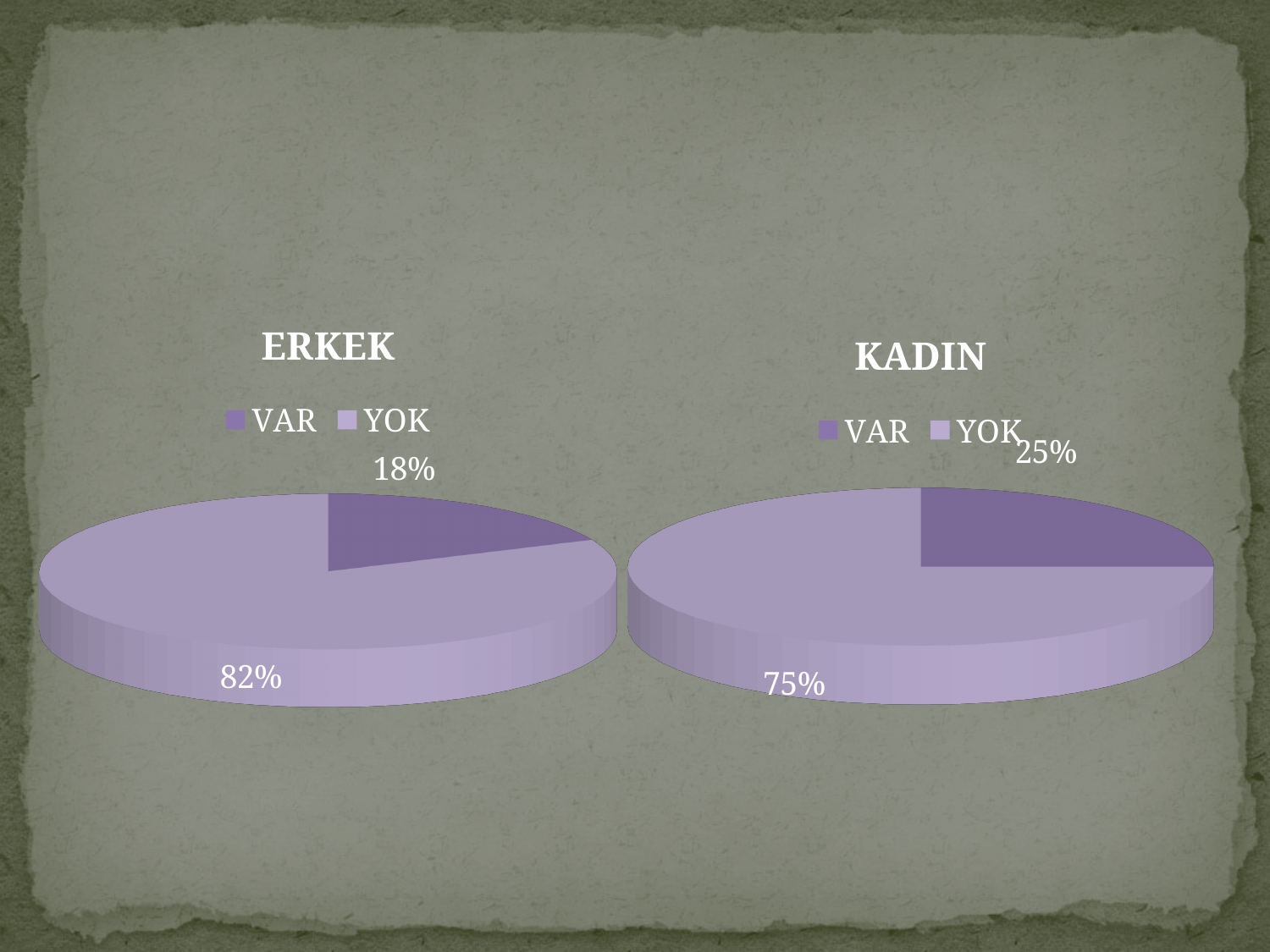
In the KADIN chart, what share does YOK have? 75% In the KADIN chart, what is the difference between the YOK and VAR shares? 50% Which chart has the larger VAR share, ERKEK or KADIN? KADIN In the ERKEK chart, which slice is the largest? YOK In the KADIN chart, what share does VAR have? 25% What kind of chart is the ERKEK chart? Pie chart What are the legend entries of the ERKEK chart? VAR, YOK In the KADIN chart, which slice is the smallest? VAR In the ERKEK chart, what share does VAR have? 18% How many slices does the KADIN chart have? 2 In the ERKEK chart, what is the difference between the YOK and VAR shares? 64%